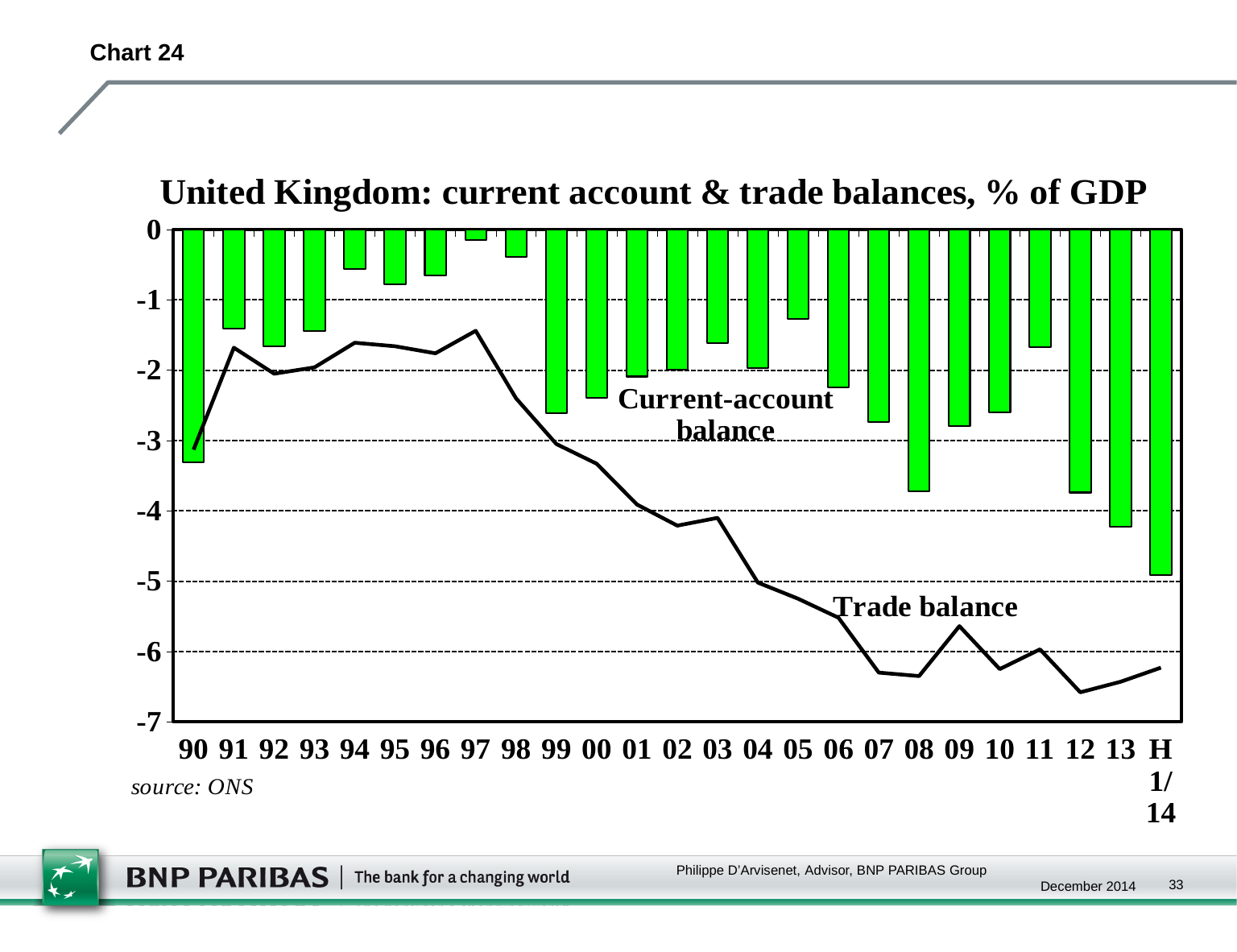
Does the trade balance line rise or fall between 97 and 07? It falls Is the trade balance for 12 greater or less than -6? less How many categories are shown along the x axis? 25 Is the current-account balance for 13 greater or less than -4? less Which year has the larger current-account balance, 90 or 91? 91 In which year is the current-account balance bar highest (closest to zero)? 97 In which period is the current-account balance bar lowest? H1/14 How many data series does the chart show? 2 Is the current-account balance for 08 greater or less than -3? less What kind of chart is shown on the slide? A combined bar and line chart What source is cited below the chart? ONS Which series is plotted as green bars? Current-account balance